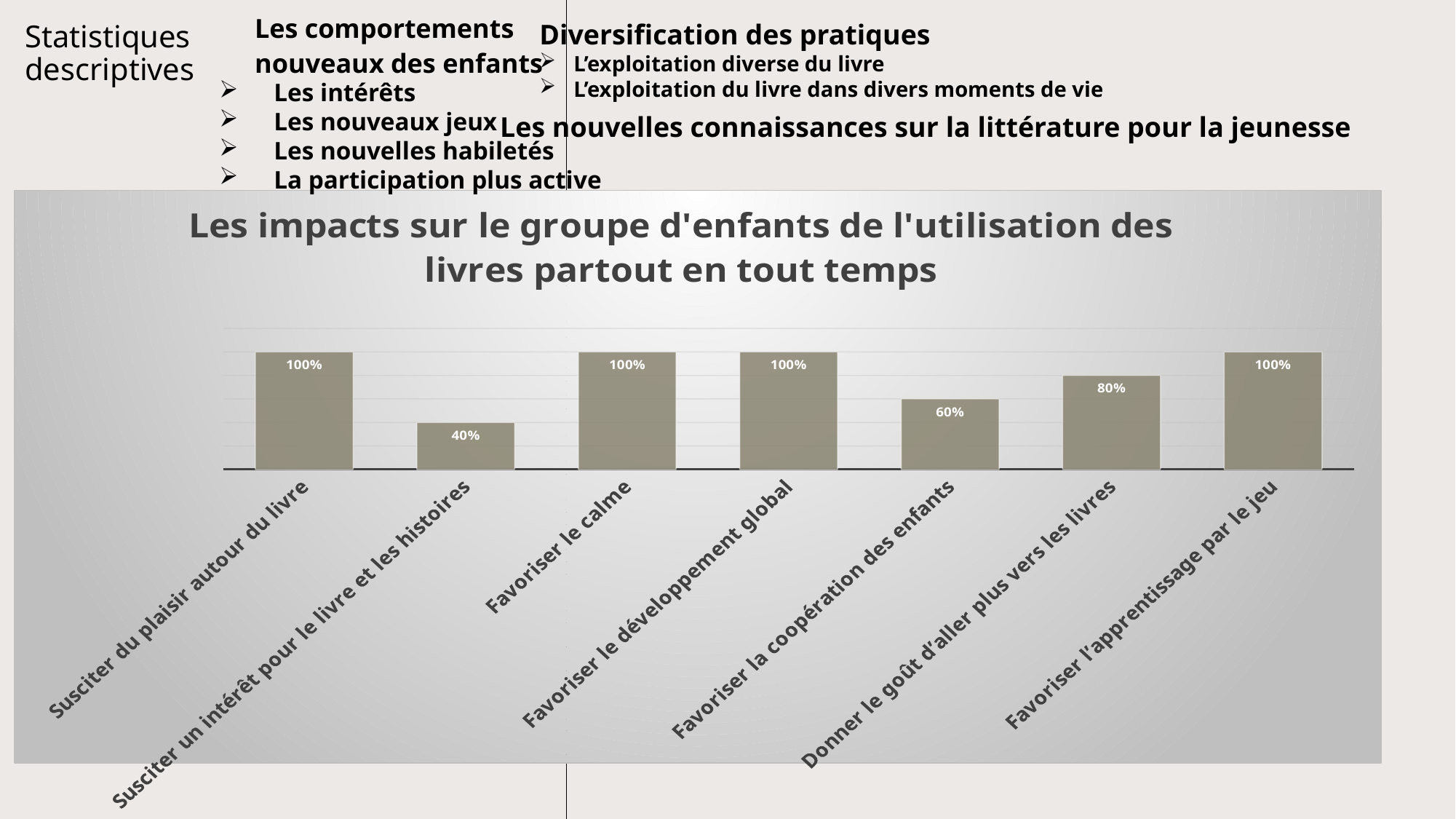
How many categories have a value of 100%? 4 What is the value for 'Favoriser le calme'? 100% What is the value for 'Susciter un intérêt pour le livre et les histoires'? 40% Which is larger: the value for 'Favoriser la coopération des enfants' or the value for 'Donner le goût d'aller plus vers les livres'? Donner le goût d'aller plus vers les livres What is the difference between the values for 'Donner le goût d'aller plus vers les livres' and 'Favoriser la coopération des enfants'? 20% Which category has the lowest value? Susciter un intérêt pour le livre et les histoires What is the difference between the values for 'Favoriser le calme' and 'Susciter un intérêt pour le livre et les histoires'? 60% What is the value for 'Favoriser la coopération des enfants'? 60% What is the value for 'Donner le goût d'aller plus vers les livres'? 80% What is the title of the chart? Les impacts sur le groupe d'enfants de l'utilisation des livres partout en tout temps What kind of chart is shown on the slide? Bar chart How many categories are shown on the chart? 7